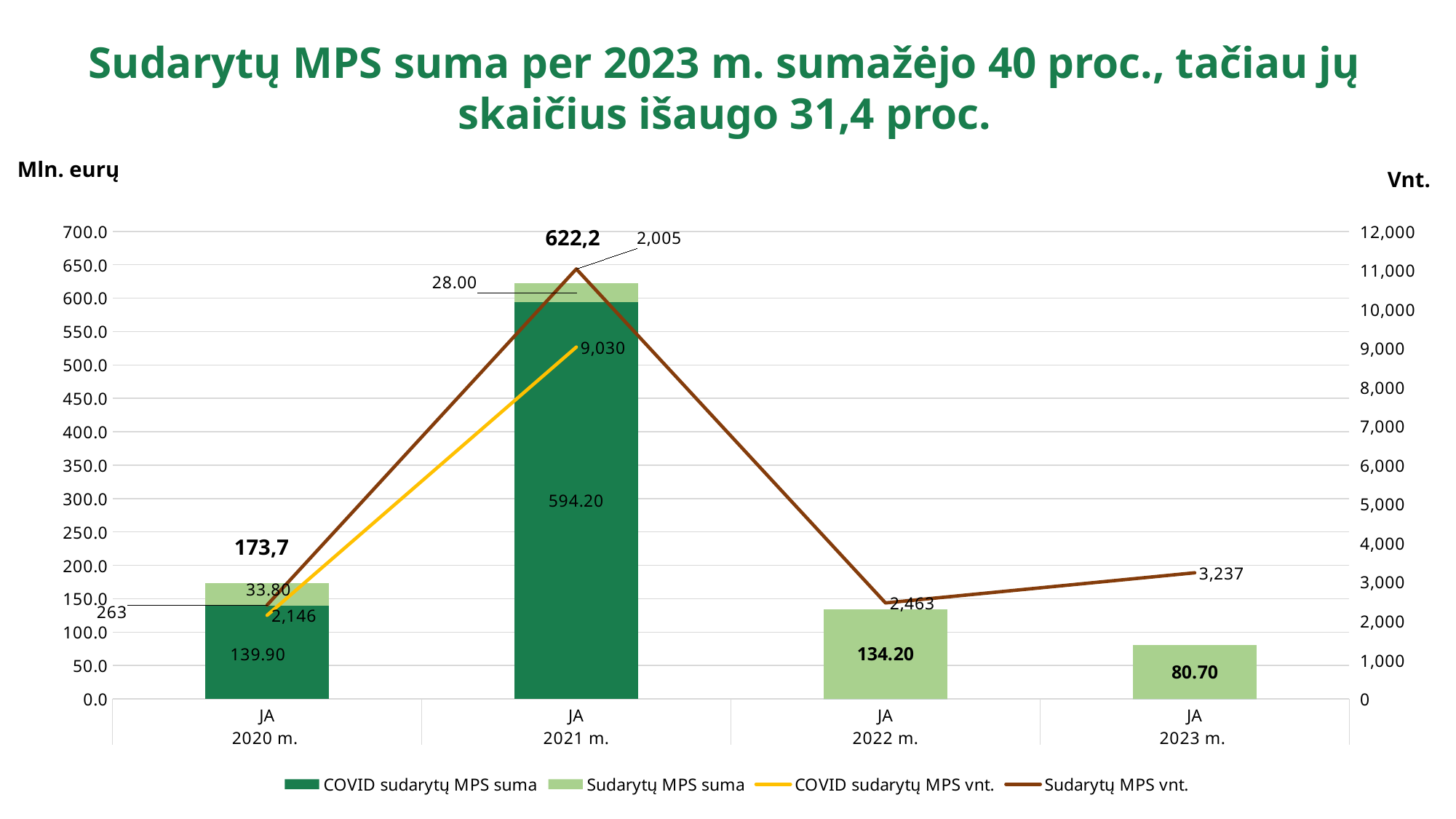
Which is larger, Sudarytų MPS vnt. for JA 2022 m. or for JA 2023 m.? JA 2023 m. Which year has the highest total bar? JA 2021 m. What is the difference between Sudarytų MPS suma for JA 2022 m. and JA 2023 m.? 53.50 How many categories are shown on the x axis? 4 What is the value of Sudarytų MPS vnt. for JA 2022 m.? 2,463 What kind of chart is this? Combined bar and line chart What is the value of COVID sudarytų MPS suma for JA 2021 m.? 594.20 What is the total of the stacked bar for JA 2021 m.? 622,2 What is the value of Sudarytų MPS suma for JA 2023 m.? 80.70 What is the value of COVID sudarytų MPS vnt. for JA 2020 m.? 2,146 Which year has the lowest value for Sudarytų MPS suma? JA 2021 m. How many series does the legend list? 4